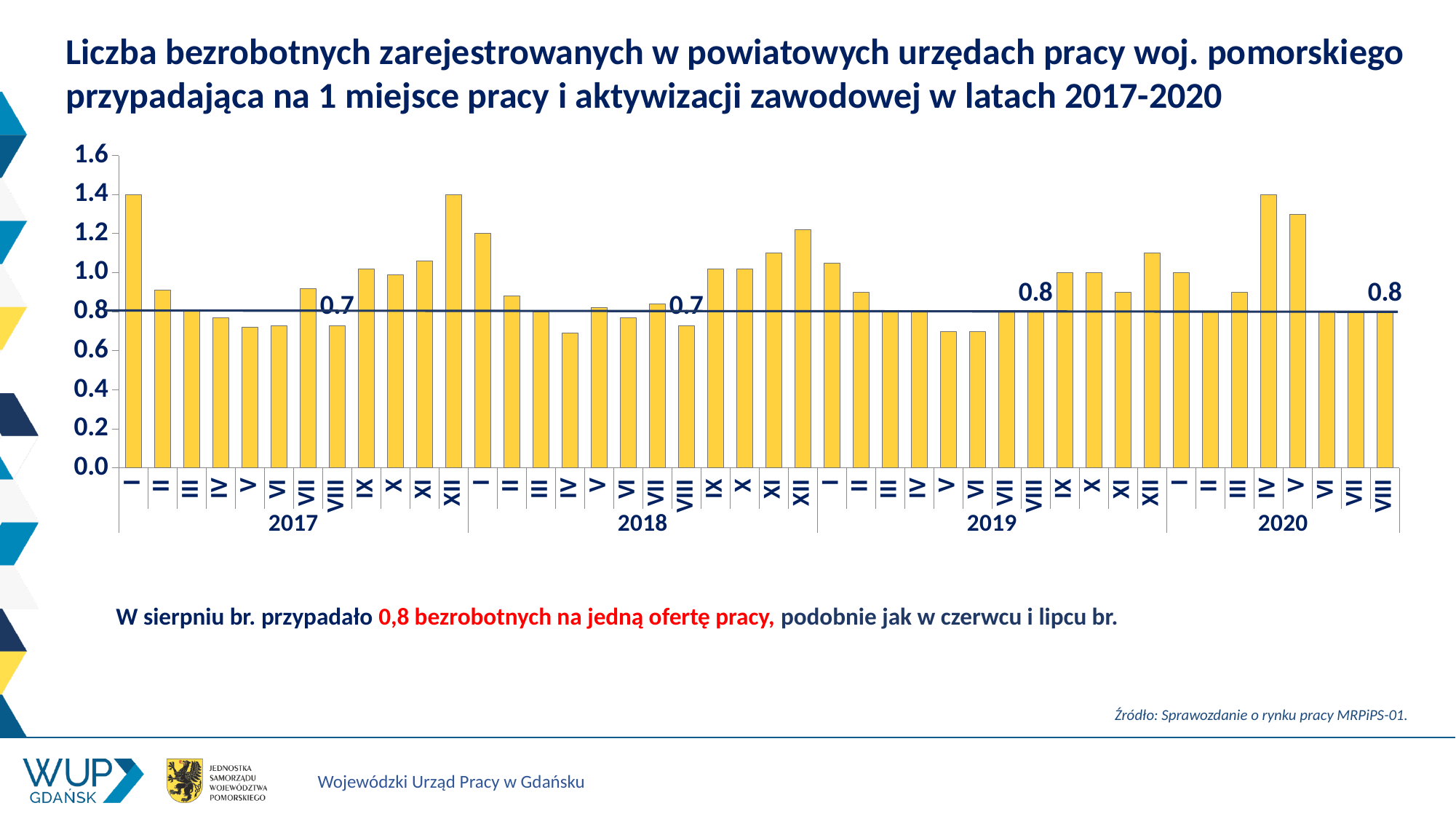
Is the value for I 2017 greater or less than 1.2? greater How many years are labelled along the x axis of the chart? 4 Is the value for V 2017 greater or less than 0.8? less What kind of chart is shown on the slide? bar chart How many bars (months) are plotted in the chart? 44 Is the value for IV 2020 greater or less than 1.2? greater Which is larger, the value for XII 2018 or the value for IV 2018? XII 2018 Which is larger, the value for I 2017 or the value for V 2017? I 2017 Do the values rise or fall from IV 2020 to VIII 2020? fall What value is labelled on the horizontal line for the 2020 section of the chart? 0.8